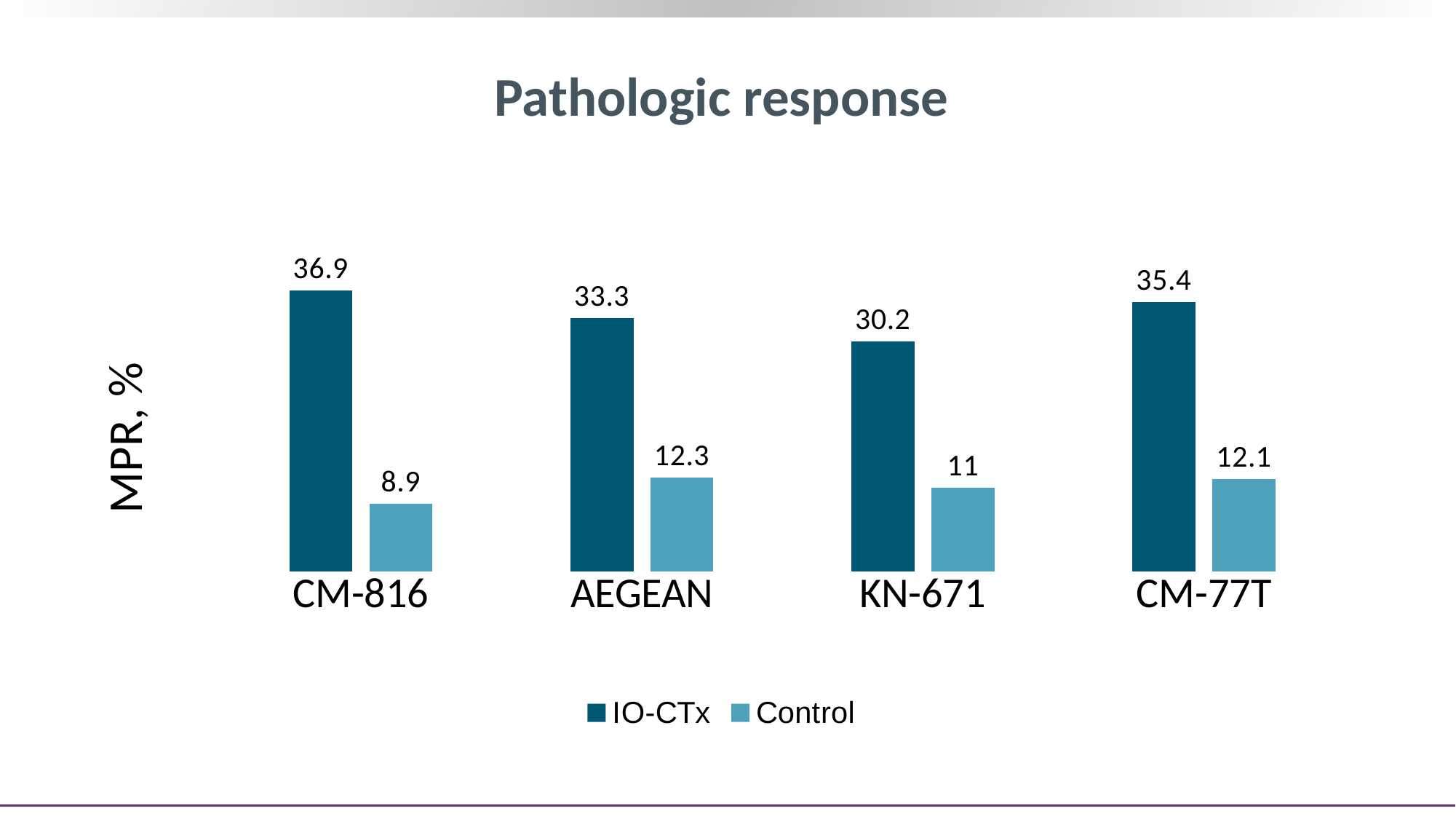
What is the difference between the IO-CTx and Control values for KN-671? 19.2 What kind of chart is shown? Bar chart What is the IO-CTx value for CM-816? 36.9 Which is larger, the IO-CTx value for AEGEAN or the IO-CTx value for CM-77T? CM-77T How many series does the legend list? 2 Which trial has the highest IO-CTx value? CM-816 What is the title of the chart? Pathologic response What is the Control value for AEGEAN? 12.3 What is the Control value for KN-671? 11 What is the IO-CTx value for CM-77T? 35.4 Which trial has the lowest Control value? CM-816 How many trials are shown on the x axis? 4